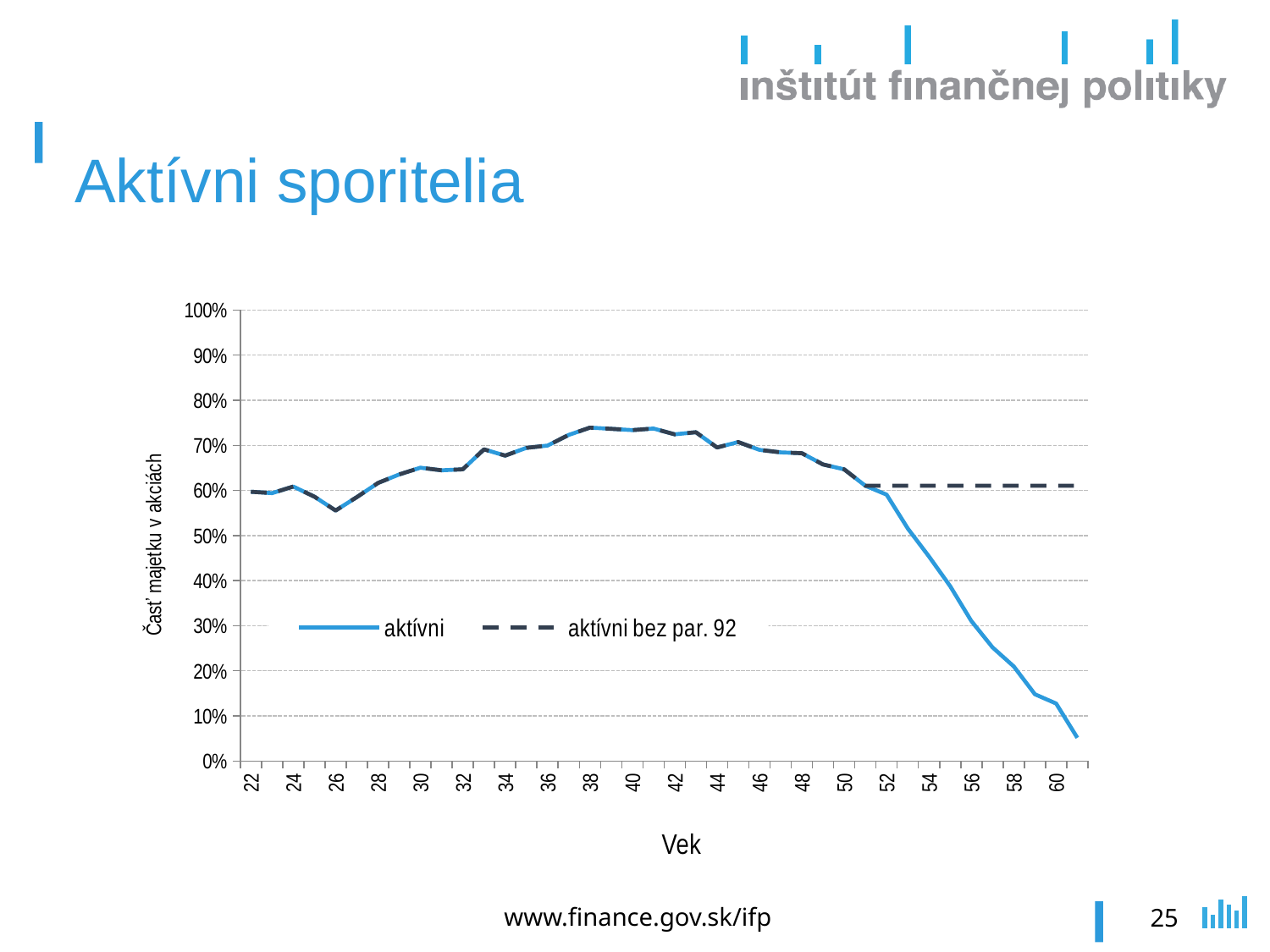
Does the aktívni series rise or fall between age 26 and age 38? rise Is the value of the aktívni bez par. 92 series at age 56 greater or less than 50%? greater Does the aktívni series rise or fall between age 52 and age 60? fall Is the value of the aktívni series at age 60 greater or less than 20%? less How many series does the legend list? 2 Is the value of the aktívni series at age 54 greater or less than 50%? less What is the title of the x axis? Vek What are the two series named in the legend? aktívni; aktívni bez par. 92 What kind of chart is shown on the slide? line chart At age 58, which series has the higher value, aktívni or aktívni bez par. 92? aktívni bez par. 92